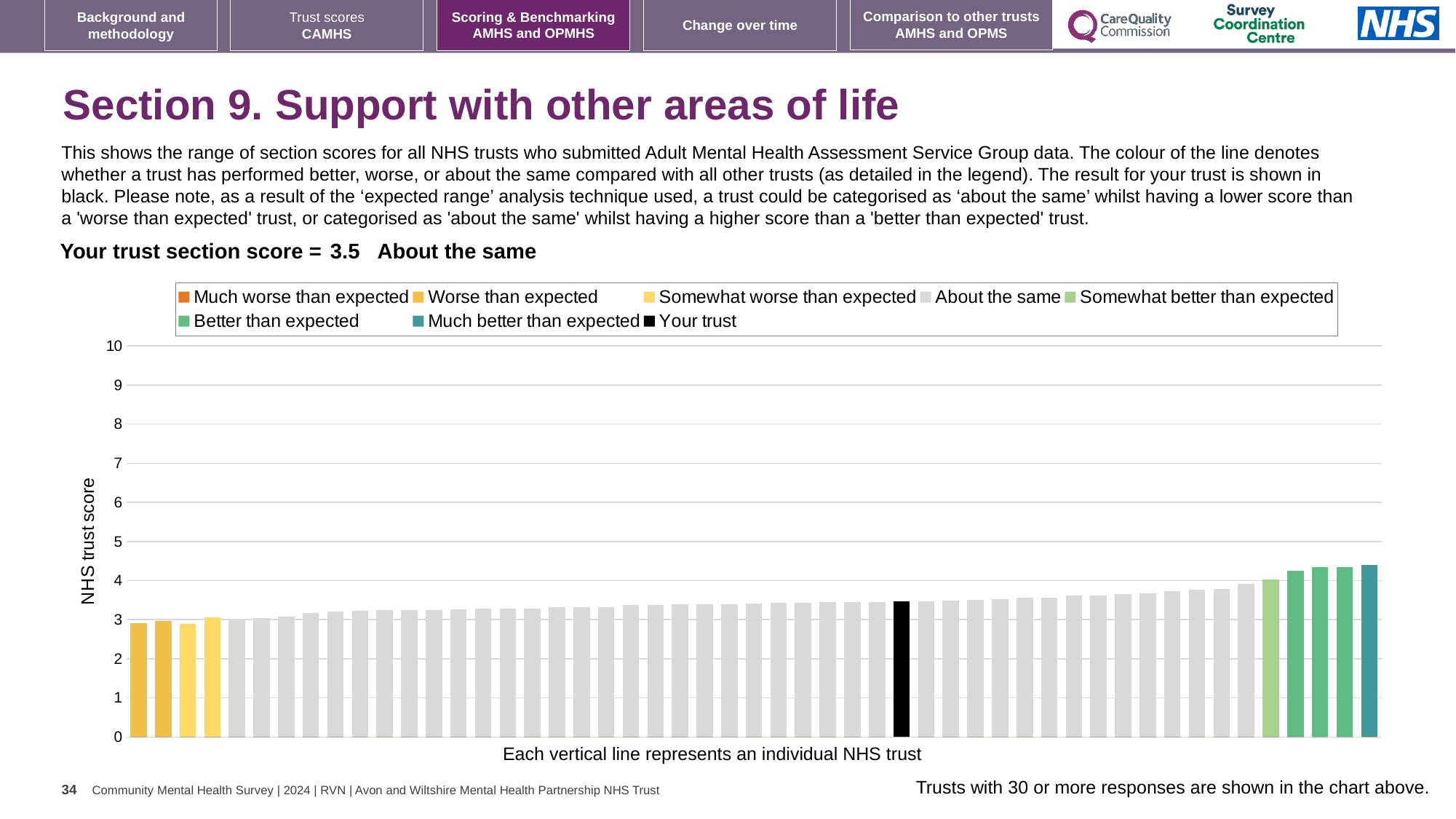
What is the section score for your trust shown on the slide? 3.5 How many bars are coloured as 'Much better than expected'? 1 Do the bar values rise or fall from left to right along the x axis? rise What is the label on the vertical axis of the chart? NHS trust score How many entries does the chart legend list? 8 Which legend category does the tallest bar in the chart belong to? Much better than expected Is the value for the black 'Your trust' bar greater or less than 4? less Is the value of the tallest bar in the chart greater or less than 4? greater Is the value for the black 'Your trust' bar greater or less than 3? greater What colour is the bar representing your trust? black What kind of chart is shown on the slide? bar chart